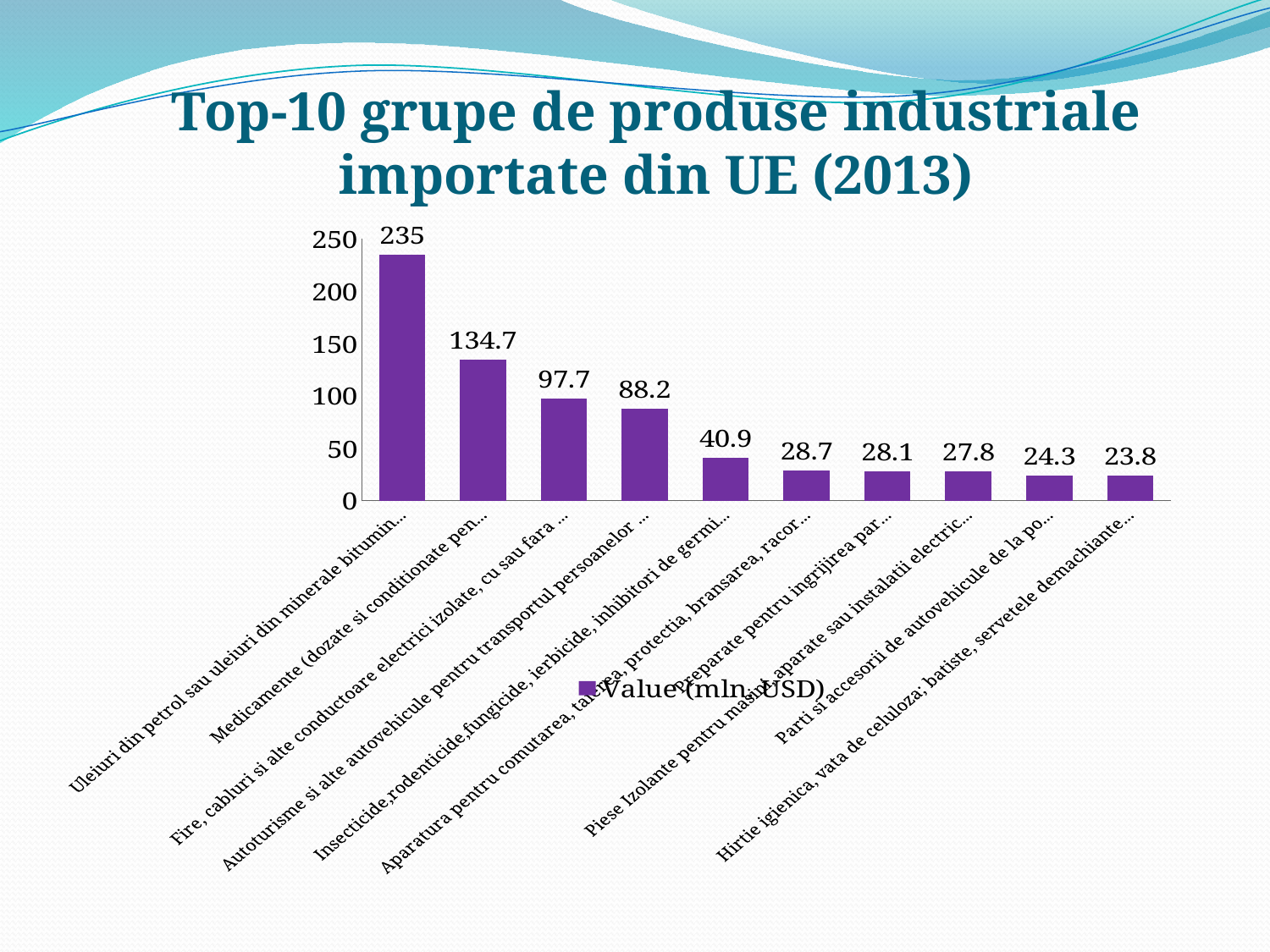
What is the difference between the values for 'Uleiuri din petrol...' and 'Medicamente'? 100.3 What is the value for the 'Hirtie igienica...' category? 23.8 Do the values rise or fall from left to right along the x axis? fall What series name does the legend show? Value (mln. USD) What is the value for the 'Uleiuri din petrol...' category? 235 How many categories are plotted in the chart? 10 Which category has the highest value? Uleiuri din petrol sau uleiuri din minerale bitumin... What is the value for the 'Autoturisme si alte autovehicule...' category? 88.2 What type of chart is shown on the slide? bar chart Which category has the lowest value? Hirtie igienica, vata de celuloza, batiste, servetele demachiante... What is the value for the 'Medicamente' category? 134.7 Which is larger: the value for 'Fire, cabluri...' or for 'Autoturisme...'? Fire, cabluri...